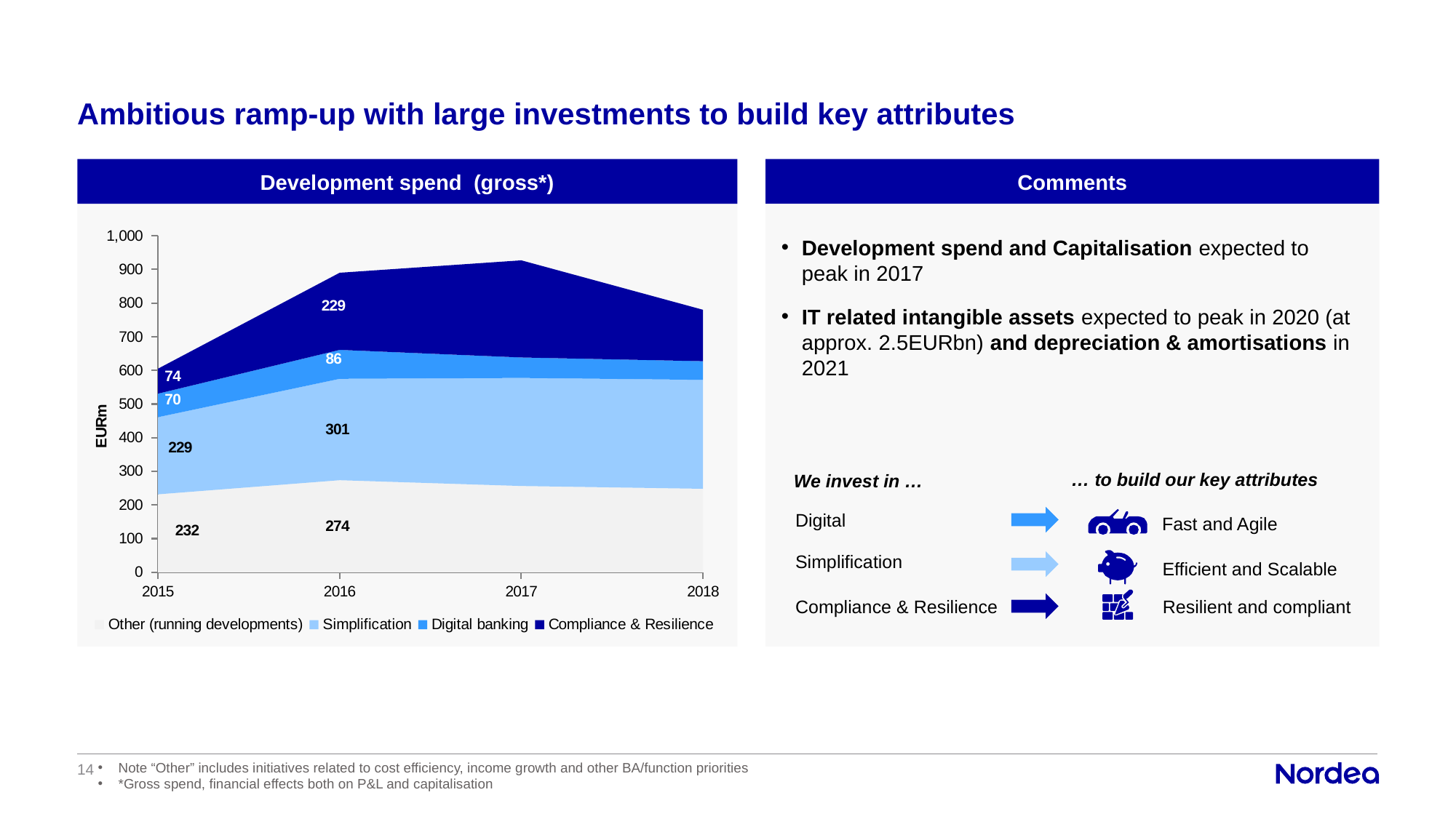
What is the total development spend in 2015, summing the four labelled series? 605 How many years are shown on the x axis of the Development spend chart? 4 Which is larger in 2016: Simplification or Other (running developments)? Simplification What is the value for Digital banking in 2015? 70 What is the total development spend in 2016, summing the four labelled series? 890 What is the value for Compliance & Resilience in 2015? 74 What is the value for Other (running developments) in 2016? 274 How many series does the legend of the Development spend chart list? 4 By how much did Compliance & Resilience spend increase from 2015 to 2016? 155 What is the value for Simplification in 2016? 301 Is the total development spend in 2017 greater or less than 900? greater What kind of chart is shown under "Development spend (gross*)"? stacked area chart